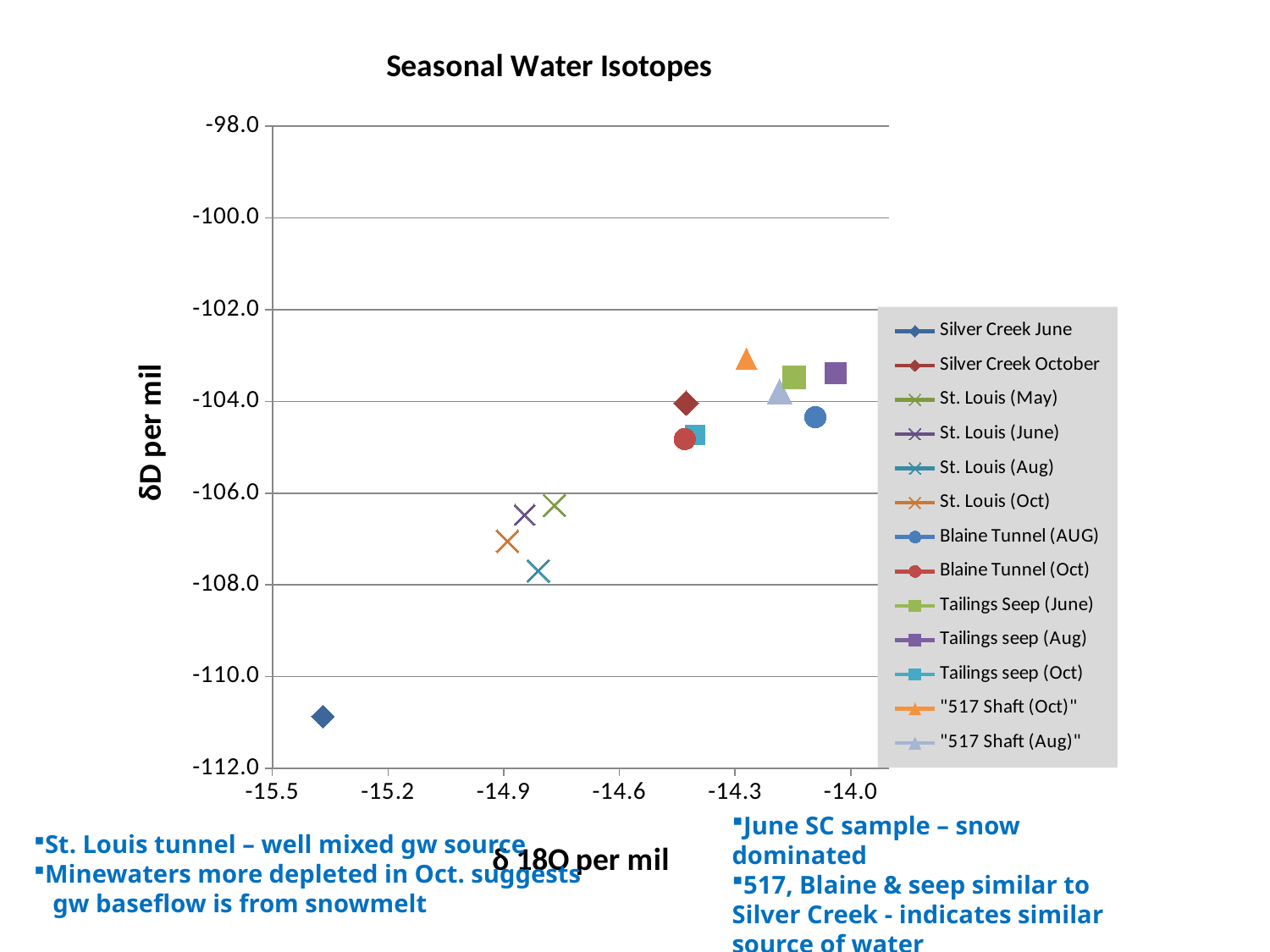
How many series does the legend list? 13 Is the δD value for Silver Creek June greater or less than -110.0? less Is the δ18O value for Silver Creek June greater or less than -15.2? less Is the δD value for St. Louis (Aug) greater or less than -108.0? greater Which series has the highest δD value? "517 Shaft (Oct)" What is the title of the chart? Seasonal Water Isotopes What kind of chart is shown on the slide? scatter chart What is the label on the vertical axis of the chart? δD per mil Which series has the lowest δD value? Silver Creek June Which has the higher δD value, Silver Creek June or Blaine Tunnel (AUG)? Blaine Tunnel (AUG)